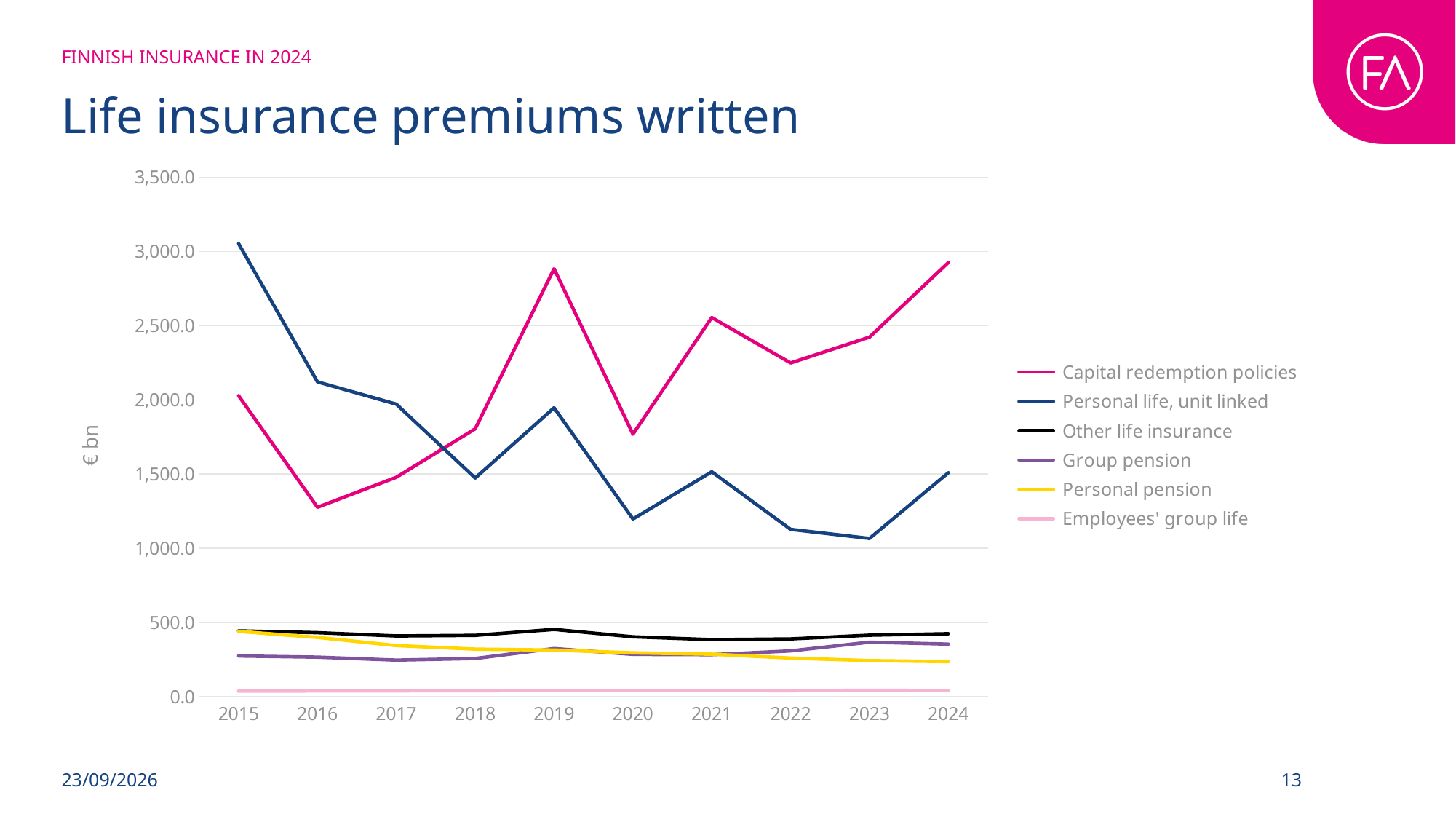
Is the value for Group pension in 2023 greater or less than 500? less Is the value for Capital redemption policies in 2016 greater or less than 1,500? less Is the value for Personal life, unit linked in 2015 greater or less than 2,500? greater In which year is Personal life, unit linked at its highest? 2015 In 2024, which is higher: Capital redemption policies or Personal life, unit linked? Capital redemption policies How many years are shown on the x axis? 10 In which year is Capital redemption policies at its lowest? 2016 What type of chart is shown on the slide? line chart In 2015, which is higher: Capital redemption policies or Personal life, unit linked? Personal life, unit linked Does the Personal pension line rise or fall from 2015 to 2024? fall What is the label on the y axis? € bn How many series does the legend list? 6